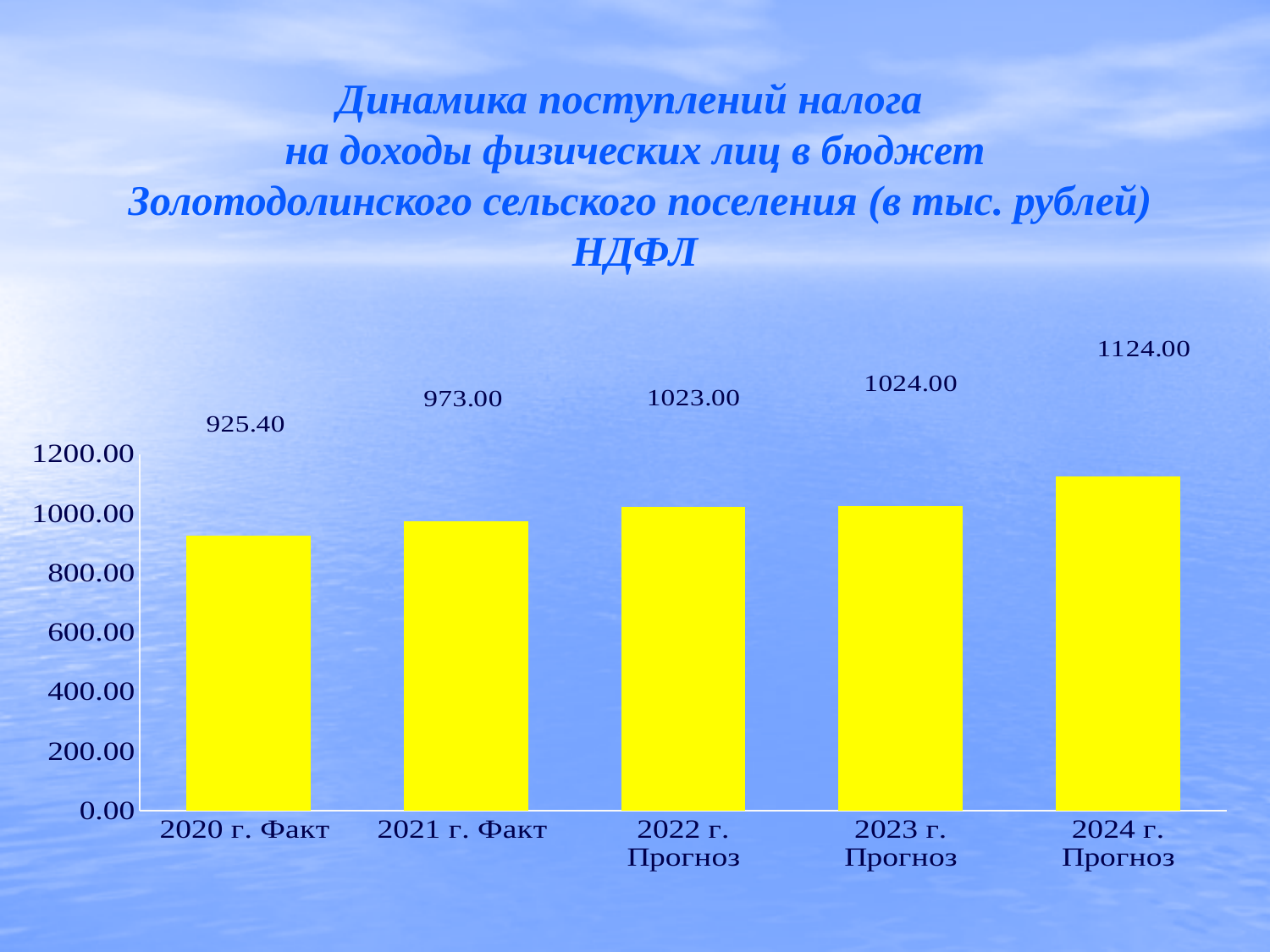
What is the difference between the values for 2021 г. Факт and 2020 г. Факт? 47.60 Which category has the lowest value? 2020 г. Факт Do the values rise or fall from 2020 г. Факт to 2024 г. Прогноз? rise Which category has the highest value? 2024 г. Прогноз What is the value for 2020 г. Факт? 925.40 How many categories are shown on the x axis? 5 What is the difference between the values for 2024 г. Прогноз and 2020 г. Факт? 198.60 What kind of chart is shown on the slide? bar chart Which is larger, the value for 2021 г. Факт or the value for 2024 г. Прогноз? 2024 г. Прогноз What is the value for 2022 г. Прогноз? 1023.00 What is the value for 2024 г. Прогноз? 1124.00 Is the value for 2020 г. Факт greater or less than 1000.00? less